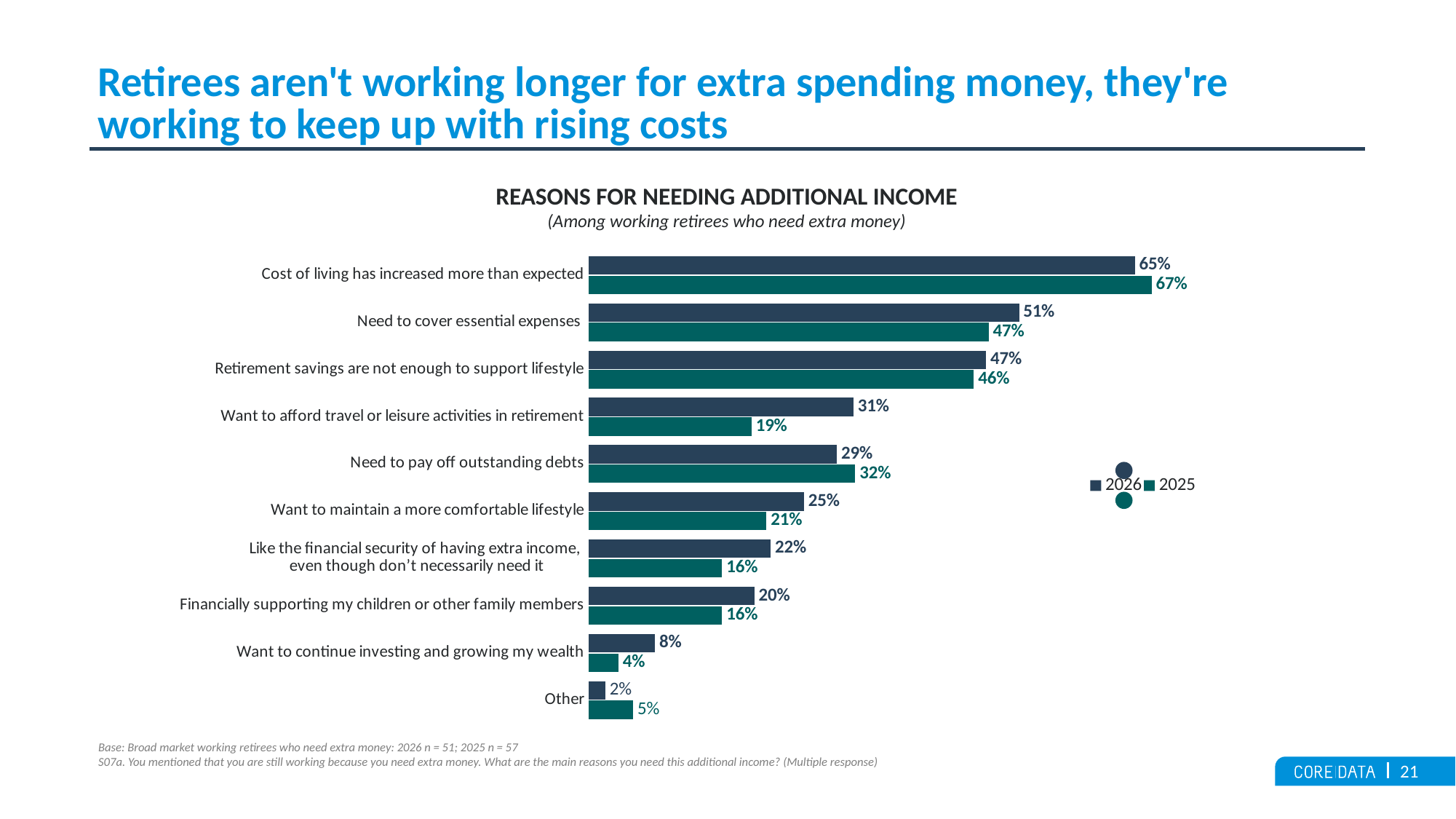
What is the 2026 value for "Need to pay off outstanding debts"? 29% What is the difference between the 2026 and 2025 values for "Want to afford travel or leisure activities in retirement"? 12 percentage points What is the title of the chart? REASONS FOR NEEDING ADDITIONAL INCOME For "Need to pay off outstanding debts", which year has the larger value, 2026 or 2025? 2025 How many categories are shown in the chart? 10 What kind of chart is shown on the slide? Bar chart What is the 2026 value for "Cost of living has increased more than expected"? 65% Which category has the lowest 2026 value? Other Which category has the highest 2025 value? Cost of living has increased more than expected What is the difference between the 2026 and 2025 values for "Need to cover essential expenses"? 4 percentage points How many series does the legend list? 2 What is the 2025 value for "Want to afford travel or leisure activities in retirement"? 19%